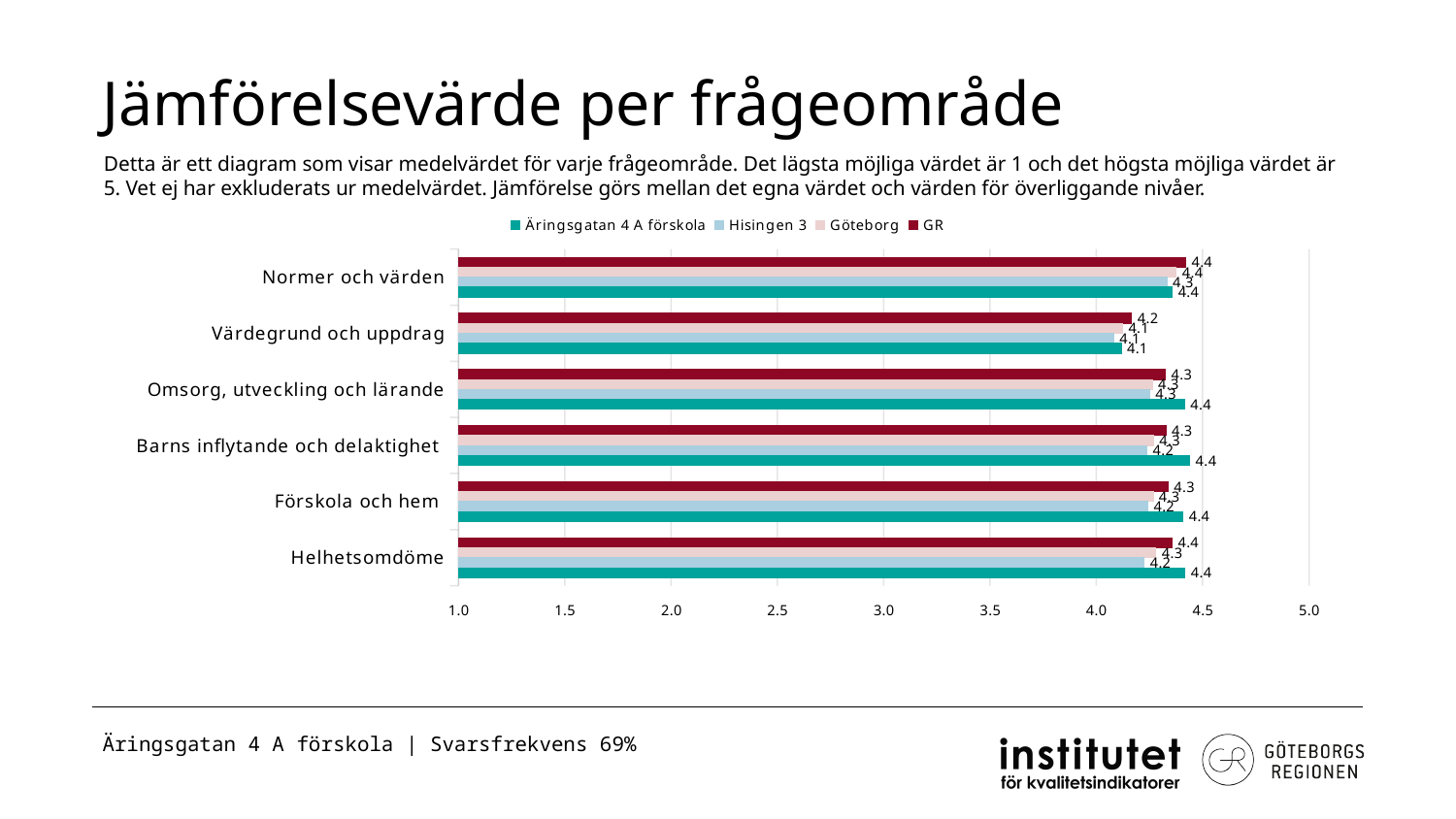
What is the value for Äringsgatan 4 A förskola in the category Omsorg, utveckling och lärande? 4.4 Which is larger in the category Förskola och hem: the value for Äringsgatan 4 A förskola or the value for Hisingen 3? Äringsgatan 4 A förskola Is the value for GR in the category Normer och värden greater or less than 4.0? greater What is the title of the chart on the slide? Jämförelsevärde per frågeområde What is the value for GR in the category Värdegrund och uppdrag? 4.2 What is the difference between the Äringsgatan 4 A förskola value and the Hisingen 3 value in the category Barns inflytande och delaktighet? 0.2 How many series does the legend list? 4 How many categories (frågeområden) are shown on the chart? 6 Which category has the lowest value for Äringsgatan 4 A förskola? Värdegrund och uppdrag What kind of chart is shown on the slide? Bar chart What is the value for Hisingen 3 in the category Helhetsomdöme? 4.2 What is the value for Äringsgatan 4 A förskola in the category Värdegrund och uppdrag? 4.1